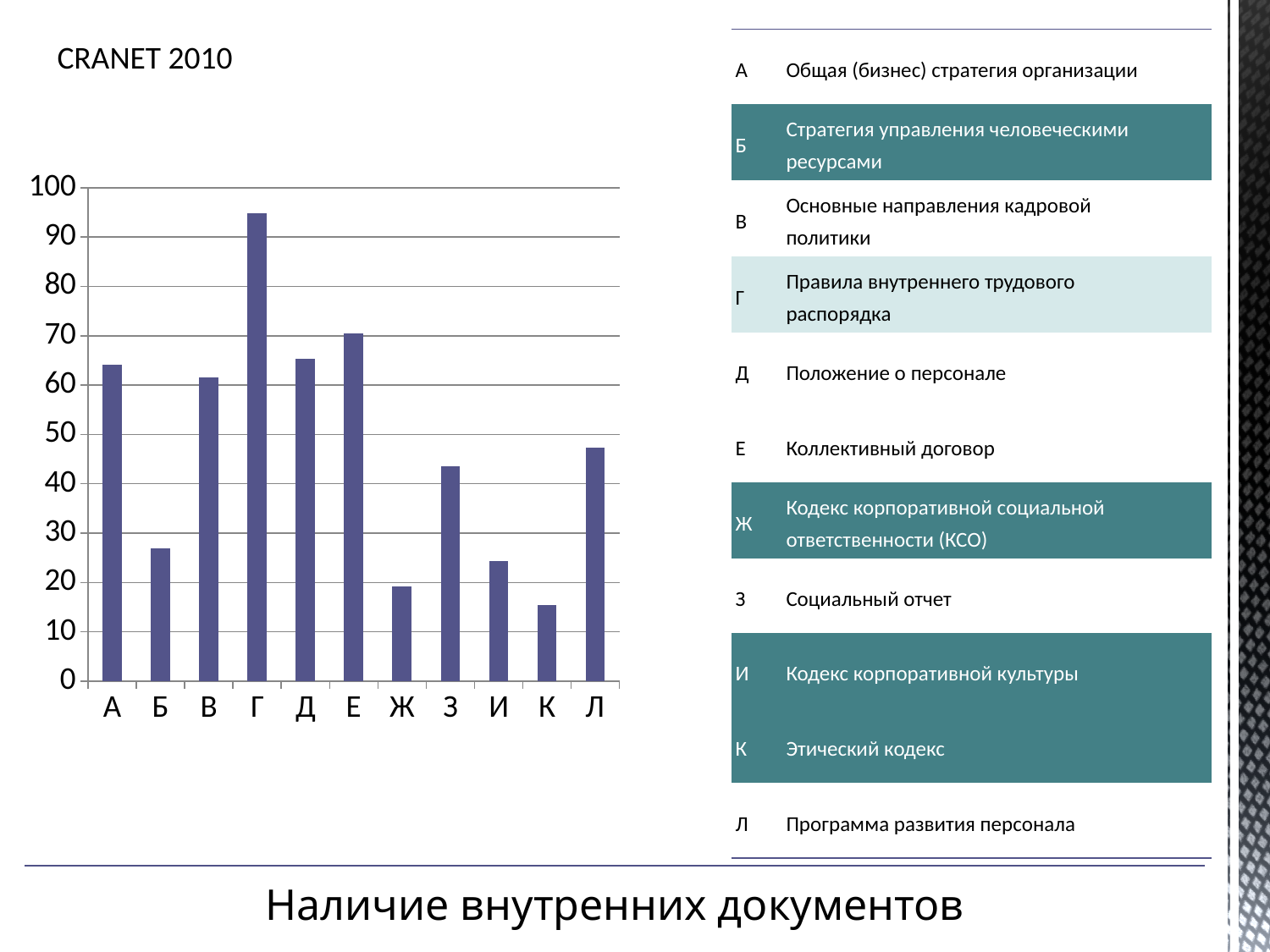
How many categories are plotted on the x axis of the chart? 11 Is the value for З greater or less than 40? greater Which is larger, the value for Б or the value for З? З Is the value for Г greater or less than 90? greater Is the value for Б greater or less than 30? less Which is larger, the value for Г or the value for Е? Г What kind of chart is shown on the slide? bar chart Which category has the lowest bar in the chart? К What is the highest tick value shown on the vertical axis of the chart? 100 Which category has the highest bar in the chart? Г